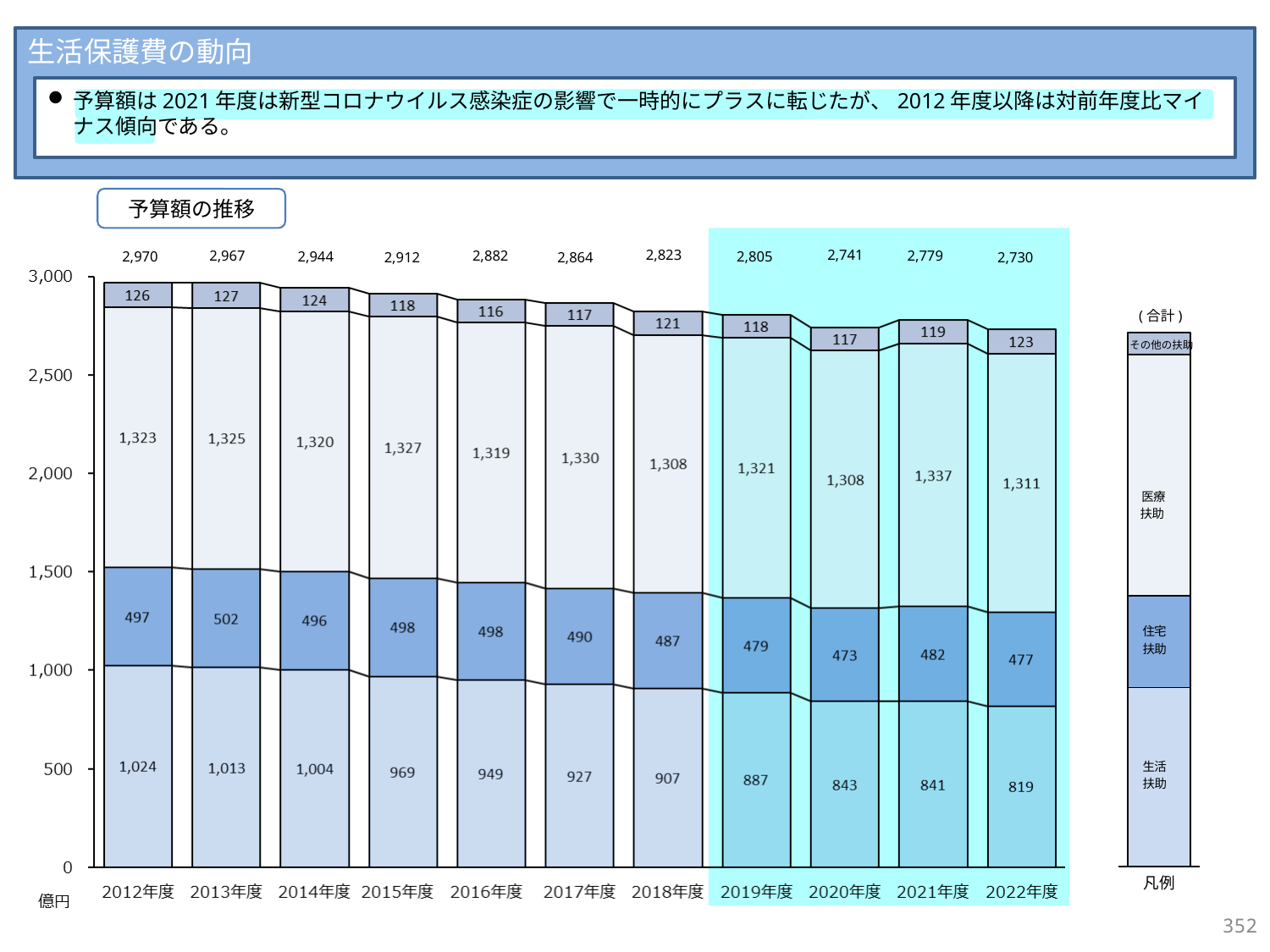
What is the difference between the total budget for 2012年度 and 2022年度? 240 Does the 生活扶助 value rise or fall from 2012年度 to 2022年度? Fall Which year has the highest 医療扶助 value? 2021年度 Which year has the highest total budget? 2012年度 What kind of chart is shown? Stacked bar chart How many categories of assistance does the legend (凡例) list? 4 Which year has the lowest total budget? 2022年度 How many fiscal years are shown on the x axis? 11 Which year has the larger 医療扶助 value, 2020年度 or 2021年度? 2021年度 What is the 住宅扶助 value for 2019年度? 479 What is the 生活扶助 value for 2012年度? 1,024 What is the total (合計) budget shown above the bar for 2021年度? 2,779